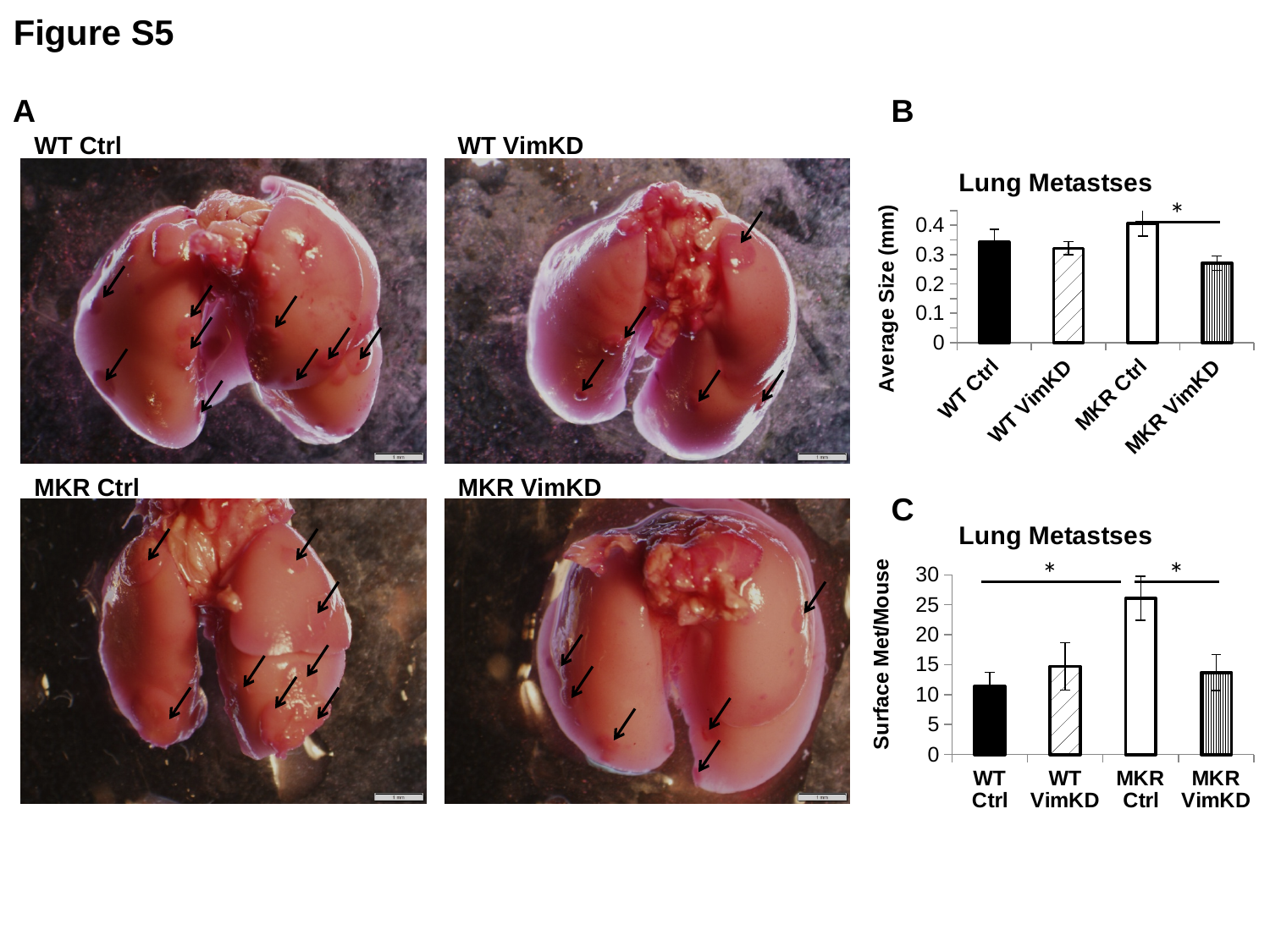
In chart B (Average Size (mm)), which category has the lowest value? MKR VimKD In chart B (Average Size (mm)), which category has the highest value? MKR Ctrl In chart C (Surface Met/Mouse), which category has the highest value? MKR Ctrl In chart C (Surface Met/Mouse), is the value for WT Ctrl greater or less than 15? less In chart C (Surface Met/Mouse), is the value for MKR Ctrl greater or less than 20? greater In chart C (Surface Met/Mouse), which is larger, the value for MKR Ctrl or the value for WT VimKD? MKR Ctrl In chart B (Average Size (mm)), is the value for MKR VimKD greater or less than 0.3? less What is the title of chart B? Lung Metastses What is the y-axis label of chart C? Surface Met/Mouse What kind of chart is chart B (Average Size (mm))? bar chart How many categories are shown on the x axis of chart C (Surface Met/Mouse)? 4